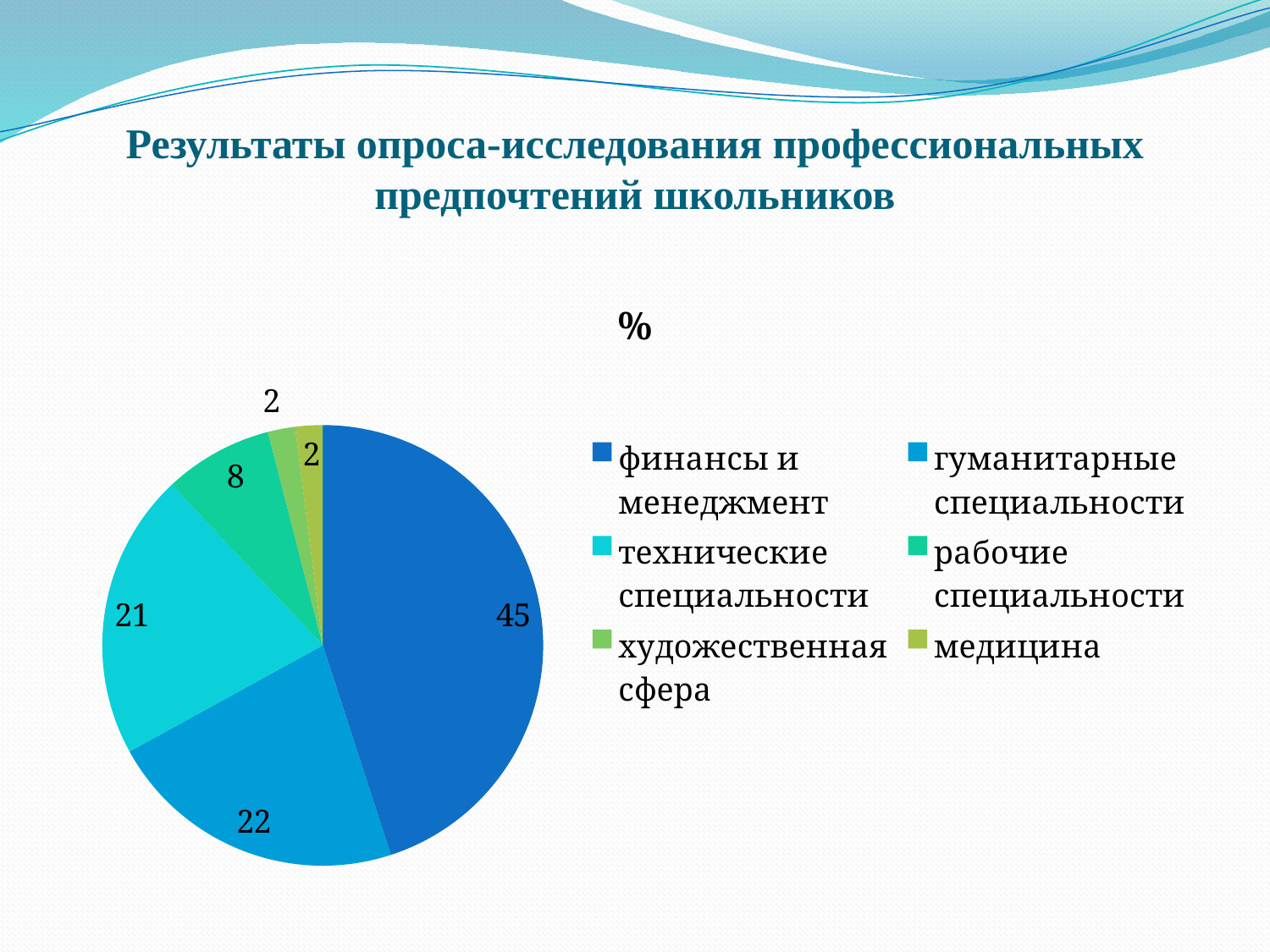
What is the difference between the values for финансы и менеджмент and гуманитарные специальности? 23 How many categories does the legend list? 6 What kind of chart is shown on the slide? pie chart What is the value for технические специальности? 21 What is the value for медицина? 2 What is the value for рабочие специальности? 8 What is the title of the chart? % Which category has the largest slice of the pie? финансы и менеджмент What is the difference between the values for рабочие специальности and художественная сфера? 6 What is the value for финансы и менеджмент? 45 What is the value for гуманитарные специальности? 22 Which is larger, the value for технические специальности or the value for рабочие специальности? технические специальности